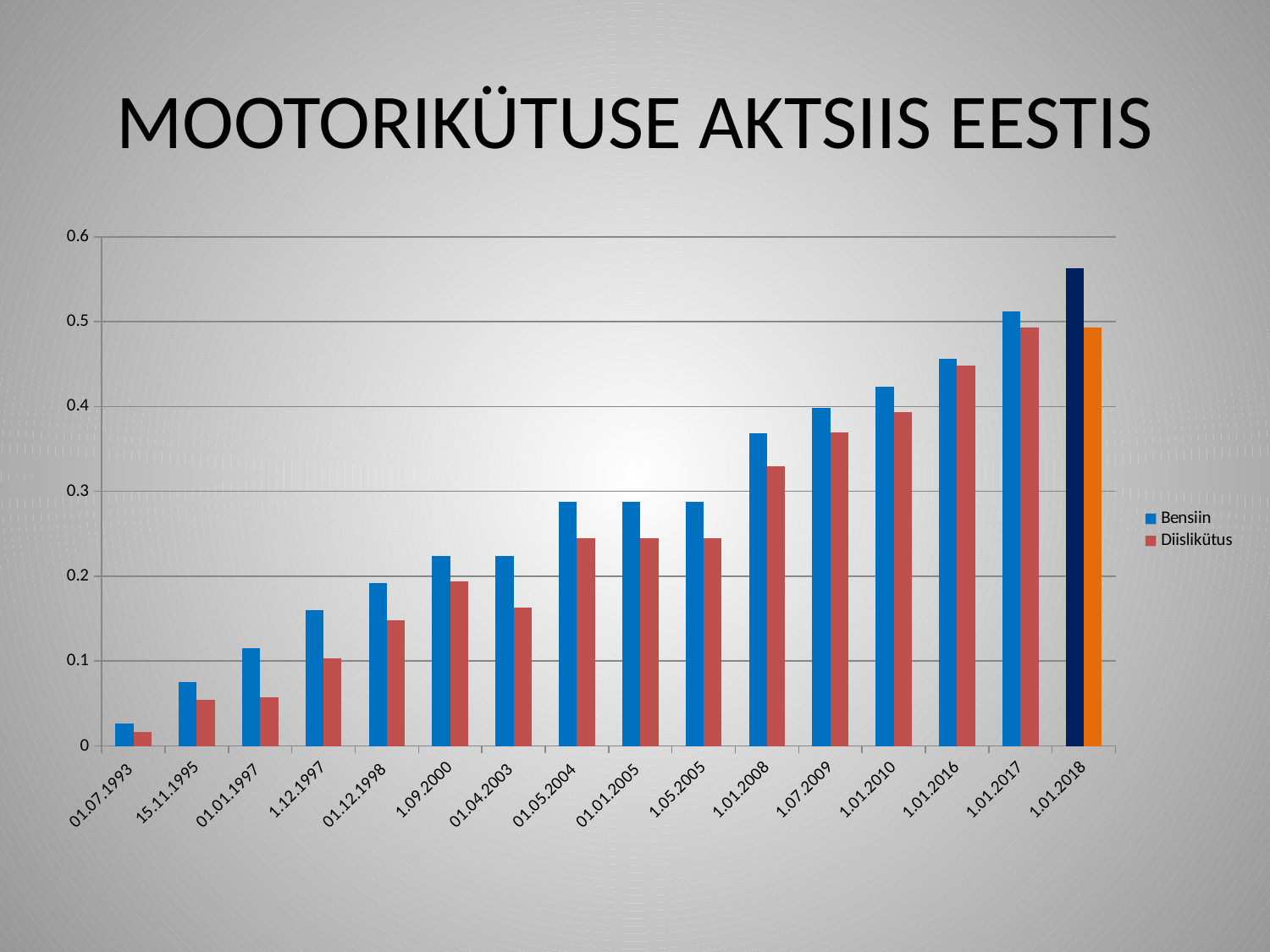
For 1.01.2008, which is larger, the Bensiin value or the Diislikütus value? Bensiin On which date is the Bensiin value highest? 1.01.2018 How many series does the legend list? 2 How many dates are shown on the x axis? 16 Do the Bensiin values generally rise or fall from 01.07.1993 to 1.01.2018? rise Is the Bensiin value for 1.01.2008 greater or less than 0.3? greater Is the Bensiin value for 1.01.2018 greater or less than 0.5? greater Is the Diislikütus value for 01.07.1993 greater or less than 0.1? less What kind of chart is shown on the slide? bar chart On which date is the Diislikütus value lowest? 01.07.1993 What is the title of the chart on the slide? MOOTORIKÜTUSE AKTSIIS EESTIS